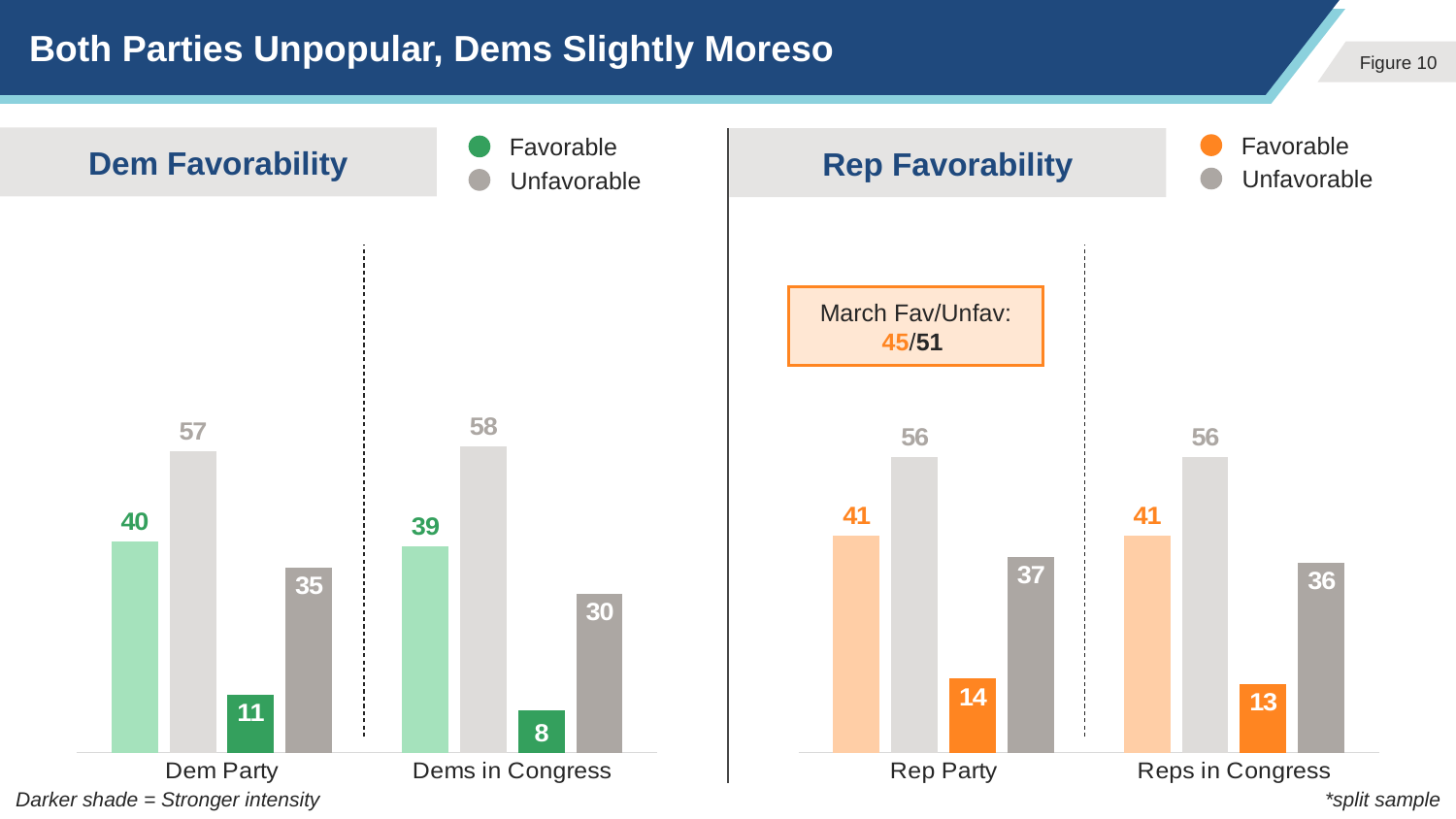
In the Dem Favorability chart, what is the unfavorable value for Dems in Congress? 58 In the Rep Favorability chart, what is the favorable value for Rep Party? 41 In the Dem Favorability chart, which is larger: the darker-shade favorable value for Dem Party or for Dems in Congress? Dem Party What type of chart is the Dem Favorability chart? Bar chart In the Dem Favorability chart, which bar has the lowest value? Dems in Congress darker-shade favorable (8) How many series does the legend of the Dem Favorability chart list? 2 In the Dem Favorability chart, what is the favorable value for Dem Party? 40 How many categories are shown on the x axis of the Rep Favorability chart? 2 In the Rep Favorability chart, what is the highest value shown? 56 In the Dem Favorability chart, what is the difference between the unfavorable and favorable values for Dem Party? 17 In the Rep Favorability chart, what is the difference between the unfavorable and favorable values for Reps in Congress? 15 In the Rep Favorability chart, what is the darker-shade (stronger intensity) unfavorable value for Reps in Congress? 36